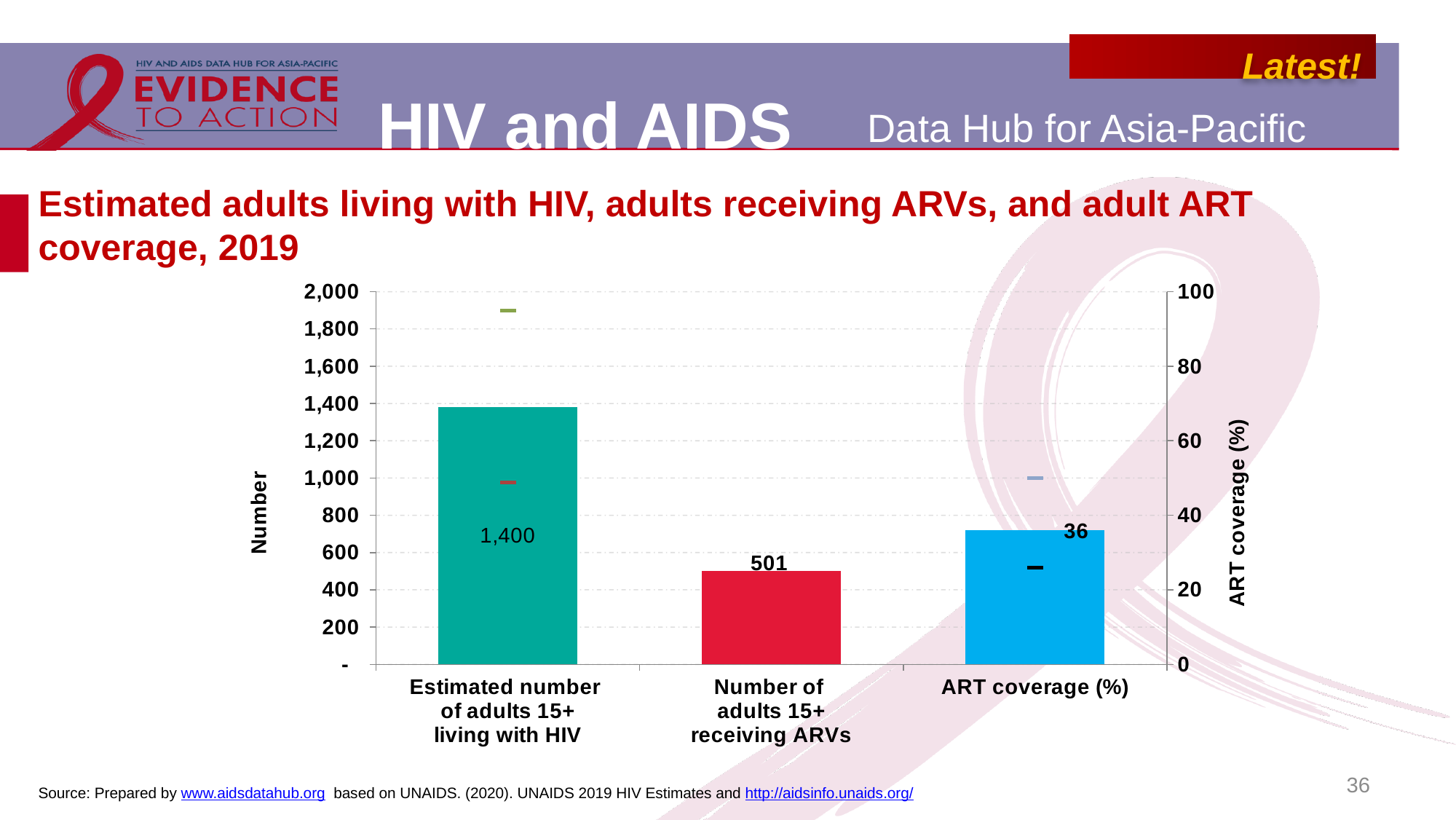
What is the title of the left vertical axis of the chart? Number Which category has the tallest bar on the chart? Estimated number of adults 15+ living with HIV What is the difference between the estimated number of adults 15+ living with HIV and the number of adults 15+ receiving ARVs? 899 What is the number of adults 15+ receiving ARVs shown on the chart? 501 What is the ART coverage (%) value shown on the chart? 36 How many categories are shown on the x axis of the chart? 3 What is the title of the right vertical axis of the chart? ART coverage (%) Is the ART coverage (%) value greater or less than 40? less What is the estimated number of adults 15+ living with HIV shown on the chart? 1,400 What kind of chart is shown on the slide? Bar chart Which is larger: the estimated number of adults 15+ living with HIV or the number of adults 15+ receiving ARVs? Estimated number of adults 15+ living with HIV Which category has the shortest bar on the chart? Number of adults 15+ receiving ARVs